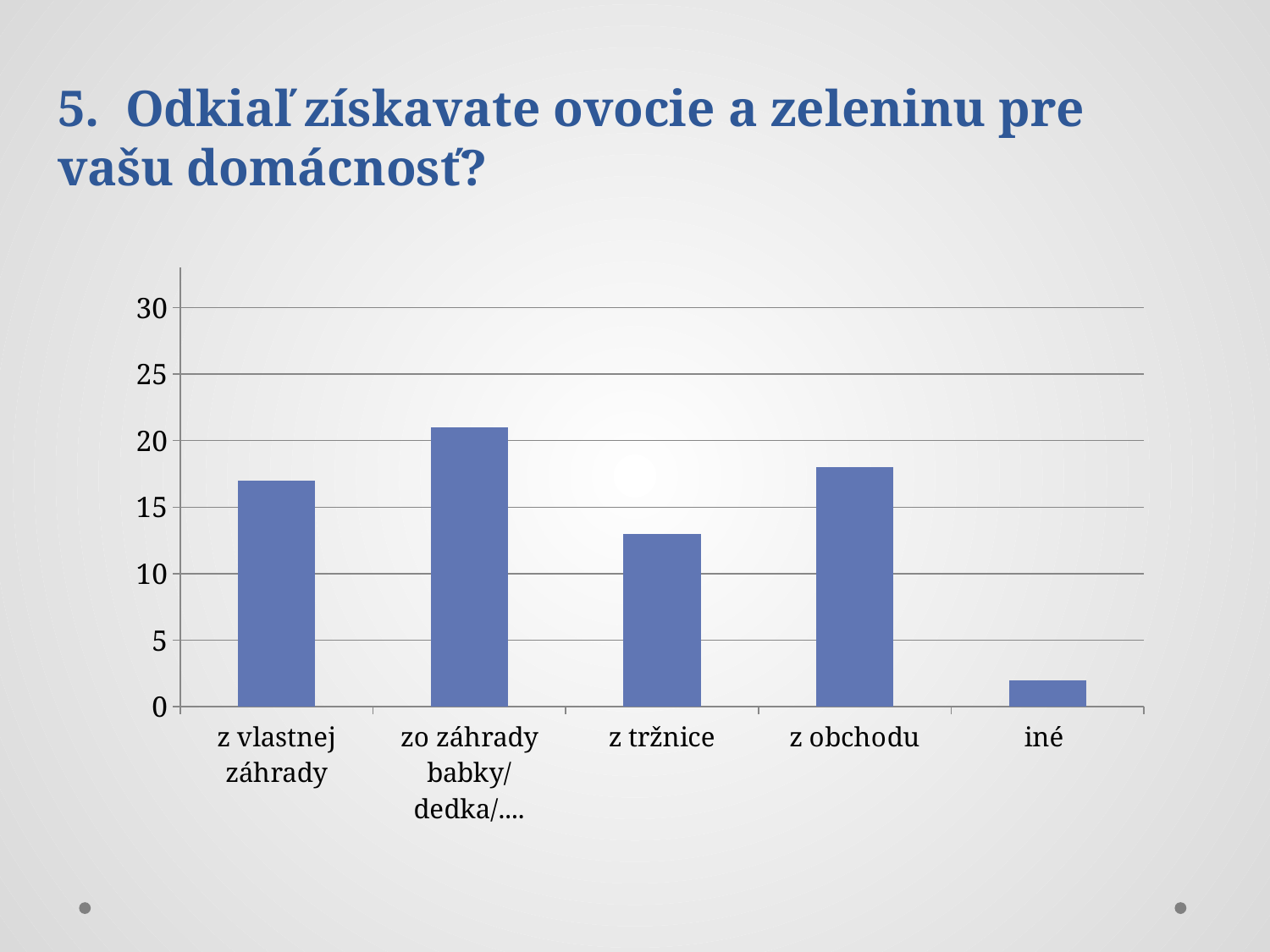
Which is larger, the value for z vlastnej záhrady or the value for z tržnice? z vlastnej záhrady What is the highest tick value shown on the vertical axis of the chart? 30 Is the value for z tržnice greater or less than 15? less Which category has the lowest bar in the chart? iné Is the value for z obchodu greater or less than 20? less Is the value for iné greater or less than 5? less How many categories are shown on the x axis of the chart? 5 What kind of chart is shown on the slide? bar chart Which category has the highest bar in the chart? zo záhrady babky/dedka/.... Which is larger, the value for z tržnice or the value for z obchodu? z obchodu